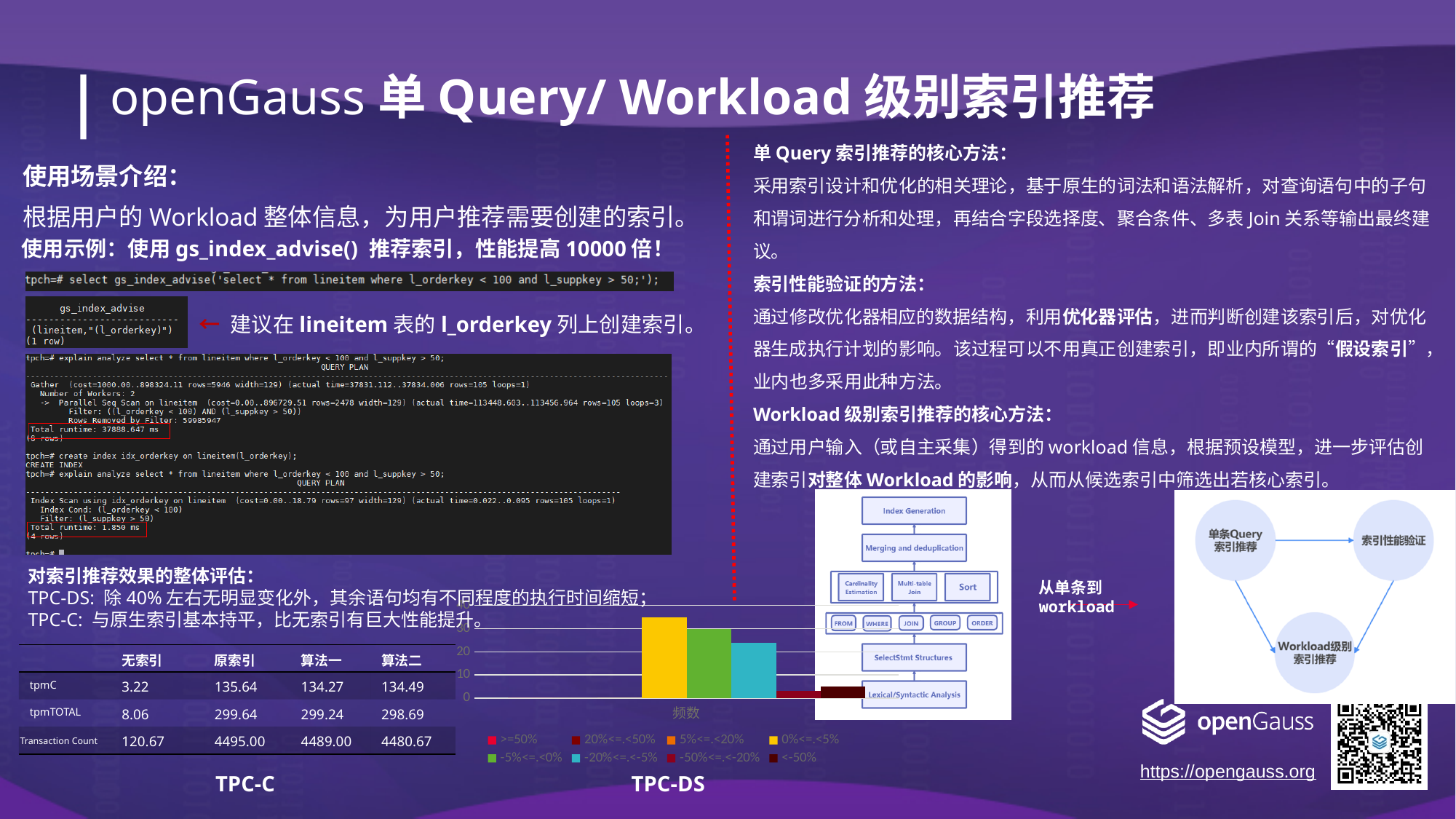
In the TPC-DS bar chart, which bar is taller: 0%<=.<5% or -5%<=.<0%? 0%<=.<5% What is the label shown on the x axis of the TPC-DS bar chart? 频数 How many series does the legend of the TPC-DS bar chart list? 8 In the TPC-DS bar chart, which series has the tallest bar? 0%<=.<5% In the TPC-DS bar chart, is the bar for 0%<=.<5% greater or less than 30? greater In the TPC-DS bar chart, is the bar for -20%<=.<-5% greater or less than 20? greater What is the highest tick value shown on the y axis of the TPC-DS bar chart? 40 What kind of chart is the TPC-DS chart at the bottom centre of the slide? bar chart In the TPC-DS bar chart, which bar is taller: 0%<=.<5% or -20%<=.<-5%? 0%<=.<5% In the TPC-DS bar chart, is the bar for -50%<=.<-20% greater or less than 10? less In the TPC-DS bar chart, which bar is taller: -5%<=.<0% or -20%<=.<-5%? -5%<=.<0%